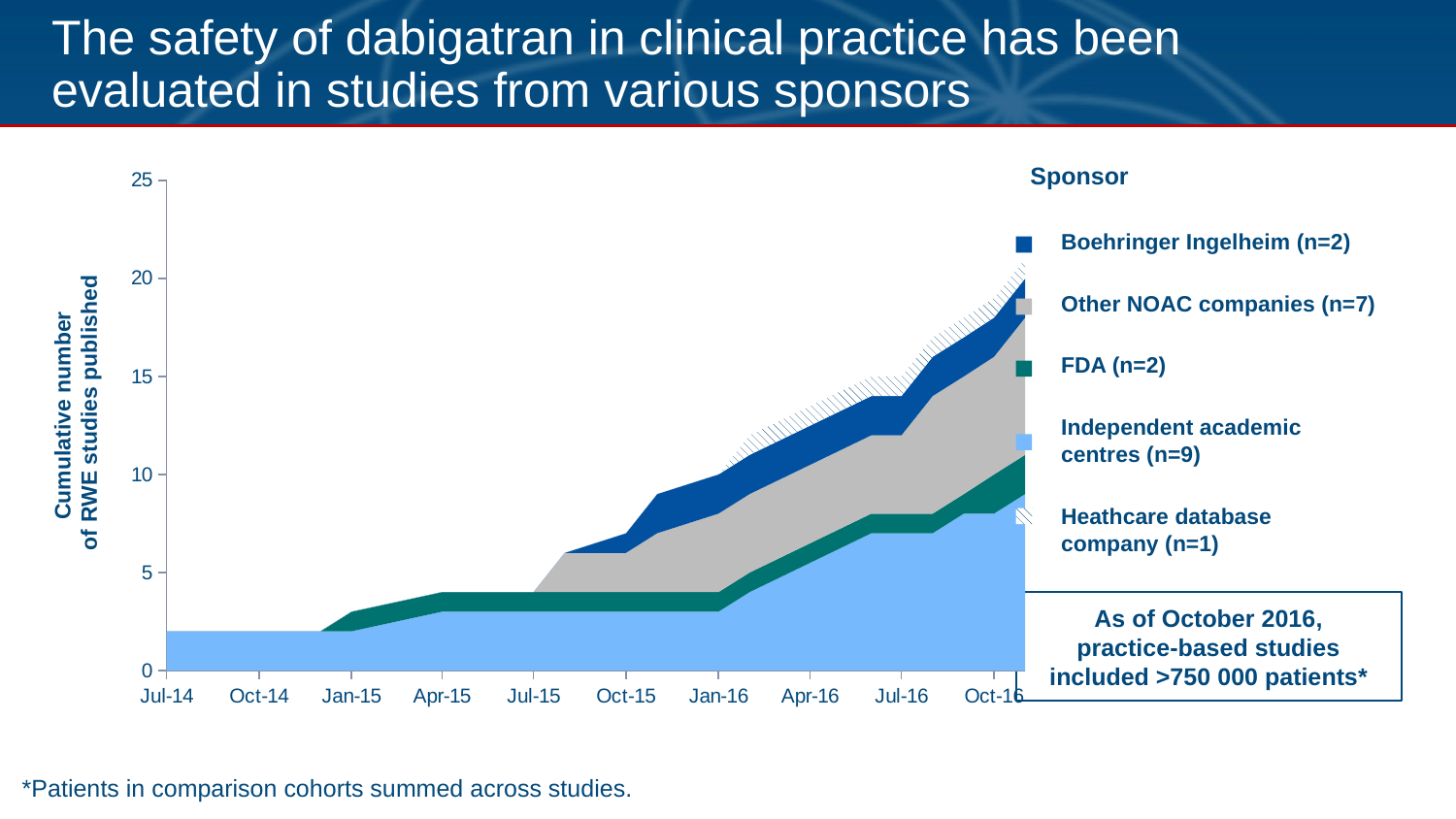
How many more studies are attributed to Independent academic centres than to Other NOAC companies? 2 Is the total cumulative number of studies at Oct-16 greater or less than 15? greater How many sponsor series does the legend list? 5 How many studies are attributed to Independent academic centres in the legend? n=9 What kind of chart is shown on the slide? Stacked area chart How many studies are attributed to Other NOAC companies in the legend? n=7 Does the cumulative number of RWE studies published rise or fall from Jul-14 to Oct-16? Rises Is the total cumulative number of studies at Oct-15 greater or less than 10? less What is the label of the y axis? Cumulative number of RWE studies published How many time points are labelled on the x axis? 10 Which sponsor has the largest number of studies according to the legend? Independent academic centres (n=9) Which sponsor has the smallest number of studies according to the legend? Heathcare database company (n=1)